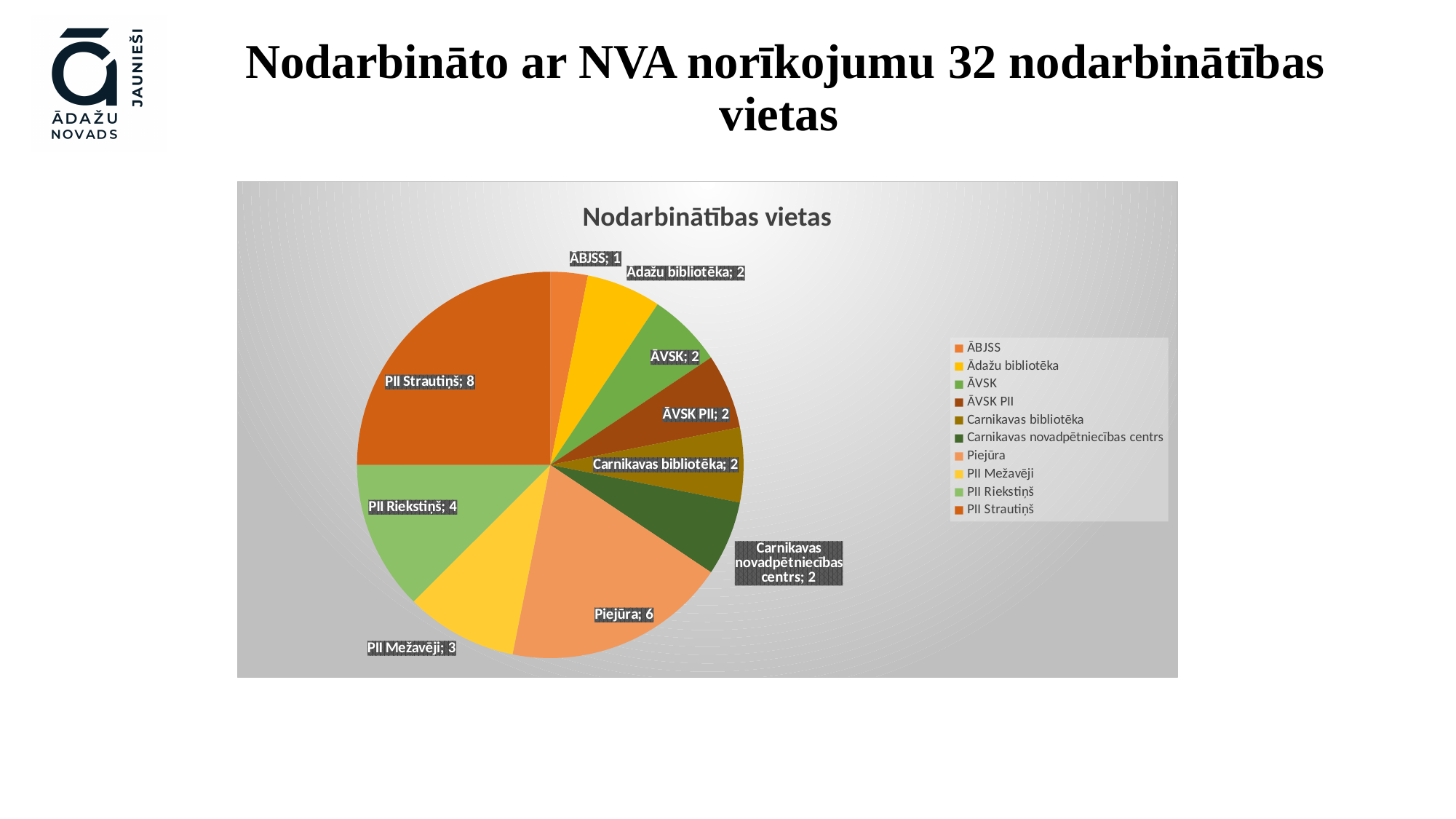
Which category has the smallest slice? ĀBJSS What share of the pie does PII Strautiņš represent? 25% What is the total of all slices in the pie chart? 32 Which is larger, the value for Piejūra or the value for PII Riekstiņš? Piejūra What is the value for Piejūra? 6 What is the difference between the values for PII Strautiņš and PII Riekstiņš? 4 How many slices does the pie chart have? 10 What is the value for PII Strautiņš? 8 What is the value for PII Mežavēji? 3 What type of chart is shown on the slide? pie chart What is the title of the chart? Nodarbinātības vietas Which category has the largest slice? PII Strautiņš